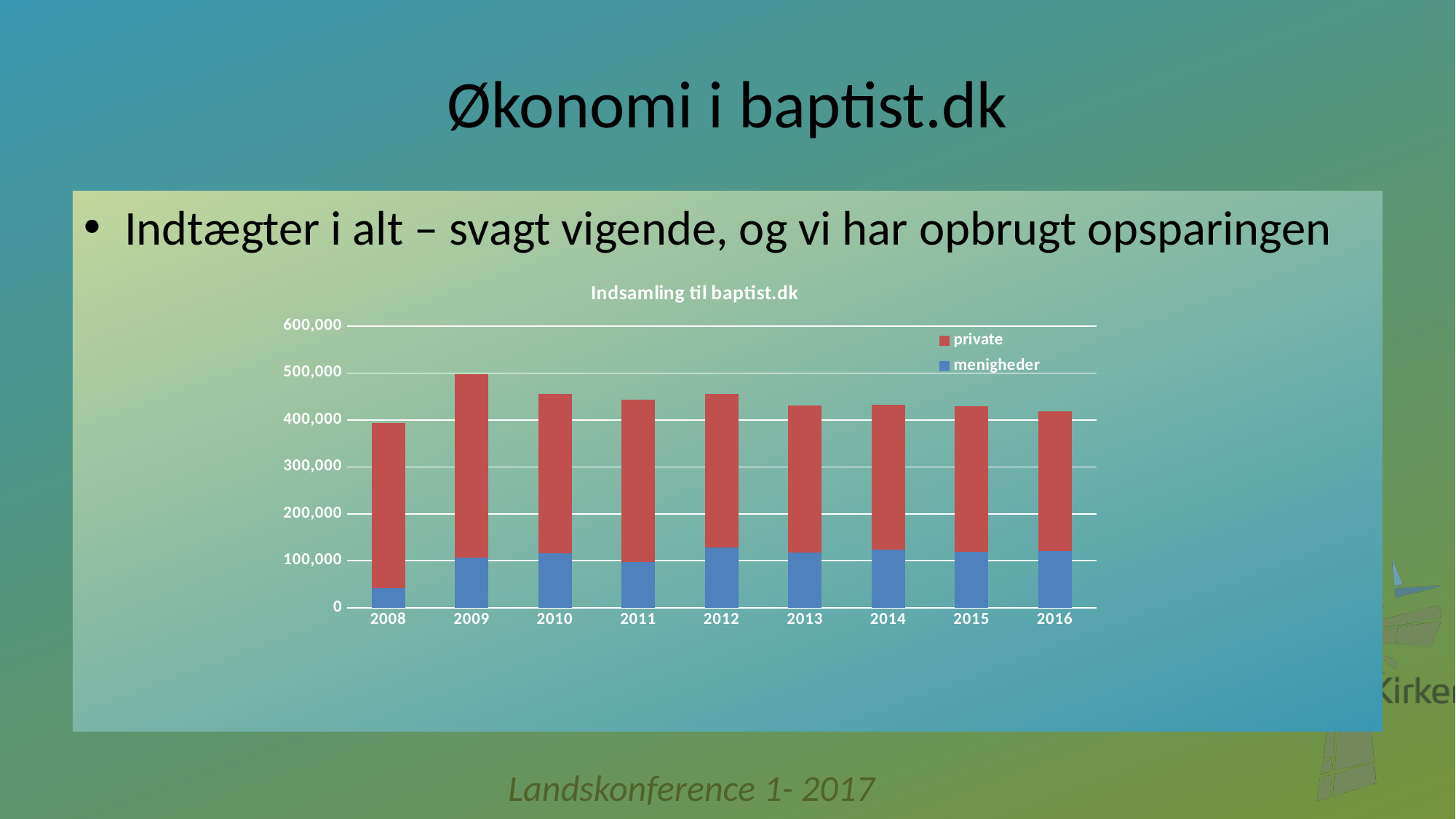
How many years are shown on the x axis of the chart? 9 Which colour represents the private series in the chart? Red Is the total bar for 2016 greater or less than 500,000? less How many series does the chart's legend list? 2 Which is larger, the menigheder value for 2008 or for 2012? 2012 Which is larger, the total bar for 2009 or the total bar for 2016? 2009 What is the title of the chart? Indsamling til baptist.dk Is the total bar for 2010 greater or less than 400,000? greater Which year has the lowest total bar in the chart? 2008 Is the menigheder value for 2008 greater or less than 100,000? less Which year has the highest total bar in the chart? 2009 What kind of chart is shown on the slide? Stacked bar chart